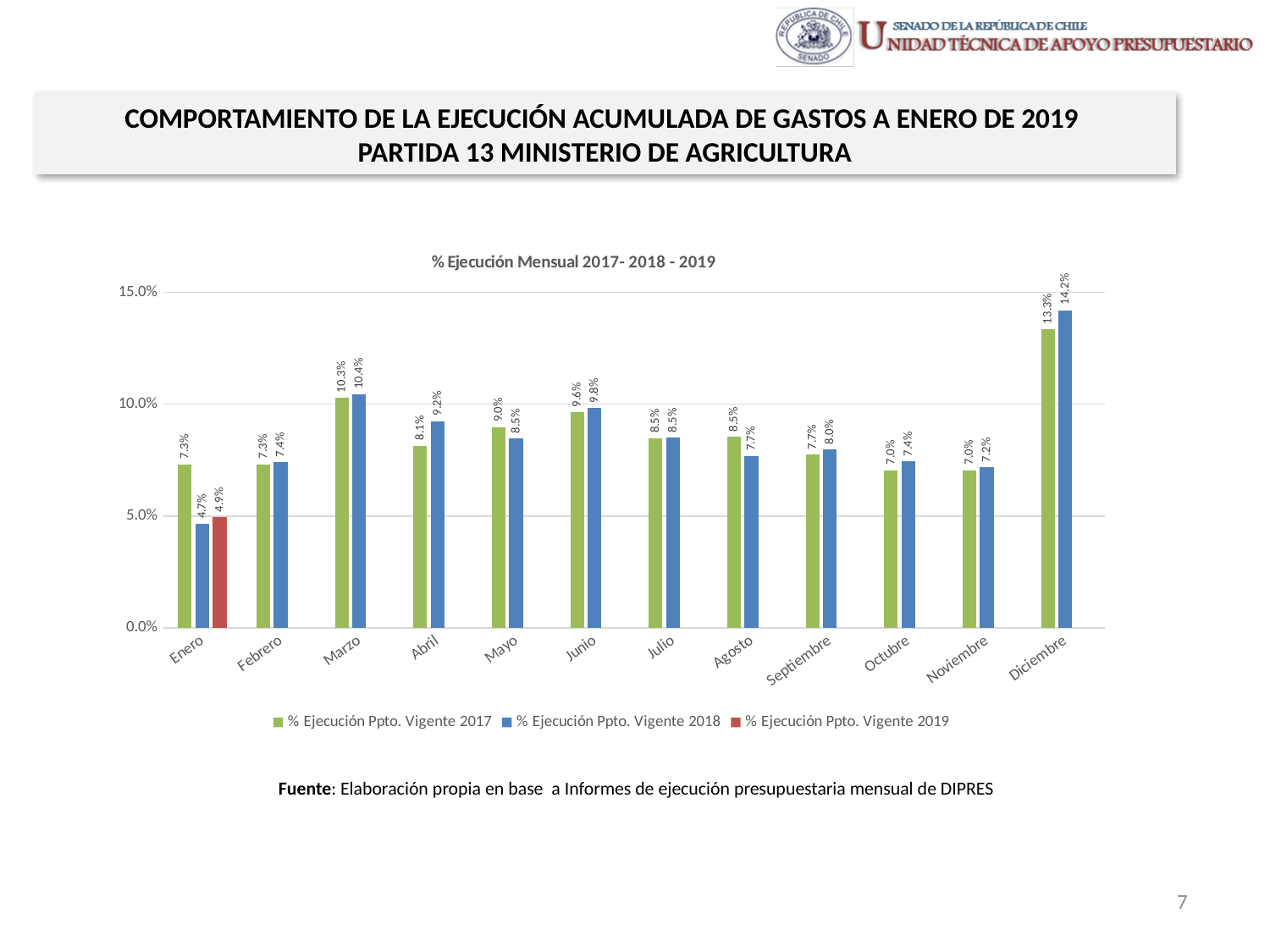
What is the value for % Ejecución Ppto. Vigente 2017 in Marzo? 10.3% Which is larger in Mayo: the 2017 value or the 2018 value? 2017 (9.0%) What is the difference between the 2018 and 2017 values in Diciembre? 0.9% What is the value for % Ejecución Ppto. Vigente 2019 in Enero? 4.9% What is the value for % Ejecución Ppto. Vigente 2018 in Abril? 9.2% How many series does the legend list? 3 Is the value for % Ejecución Ppto. Vigente 2017 in Diciembre greater or less than 10.0%? greater What kind of chart is shown on the slide? Bar chart Which month has the highest value for % Ejecución Ppto. Vigente 2018? Diciembre Which month has the lowest value for % Ejecución Ppto. Vigente 2018? Enero How many months are shown on the x axis? 12 What is the title of the chart? % Ejecución Mensual 2017- 2018 - 2019